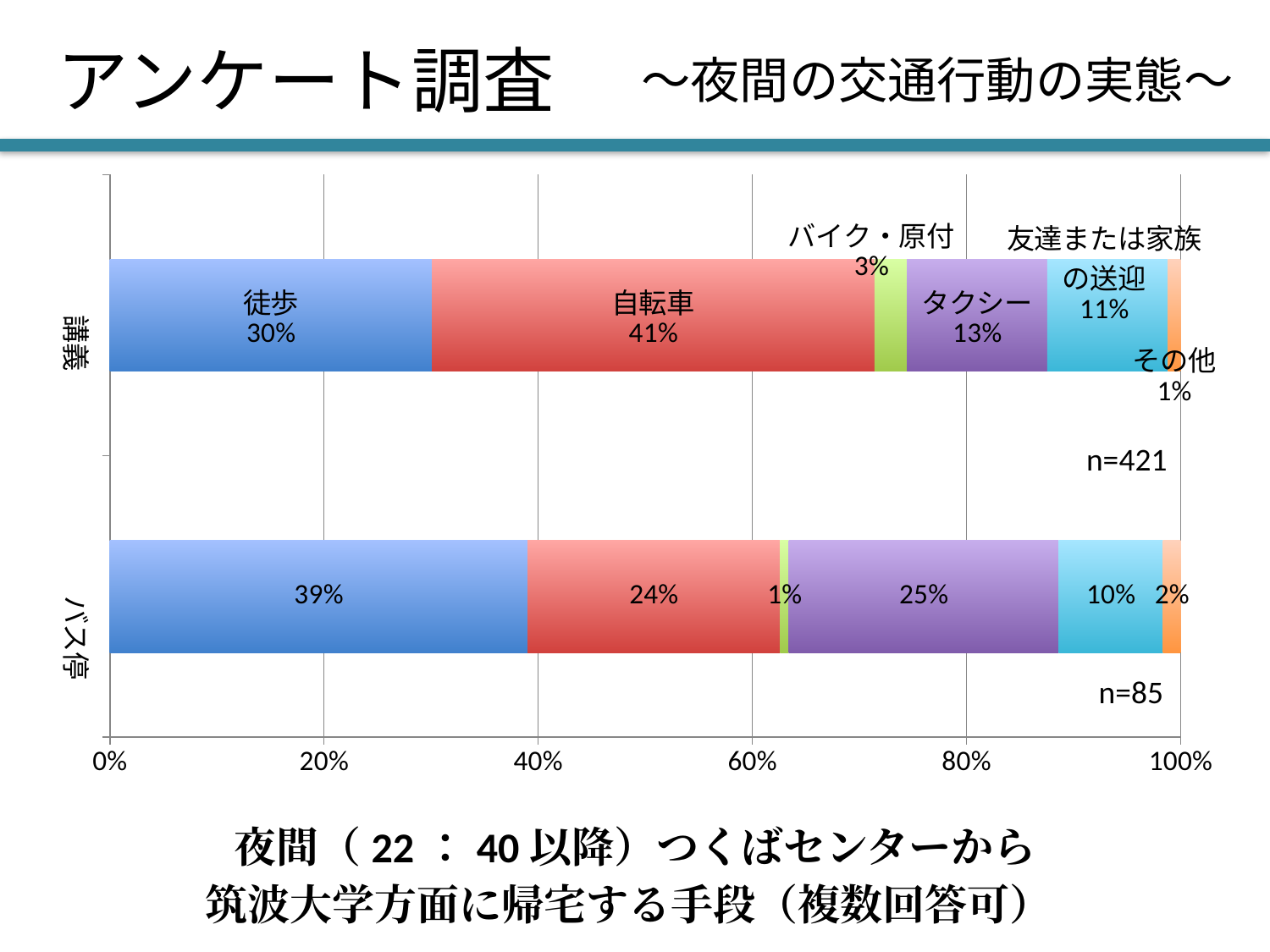
What is the value for 自転車 in the 講義 bar? 41% What is the value for 徒歩 in the 講義 bar? 30% What is the value for バイク・原付 in the 講義 bar? 3% What is the difference between the 徒歩 share in the バス停 bar and the 徒歩 share in the 講義 bar? 9% What is the sample size (n) shown for the バス停 bar? n=85 How many categories (bars) are plotted on the chart? 2 What is the value for タクシー in the バス停 bar? 25% What type of chart is shown on the slide? stacked bar chart What is the sample size (n) shown for the 講義 bar? n=421 Which transport mode has the largest share in the 講義 bar? 自転車 Which is larger: the 自転車 share in the 講義 bar or the 自転車 share in the バス停 bar? 講義 Which transport mode has the smallest share in the 講義 bar? その他